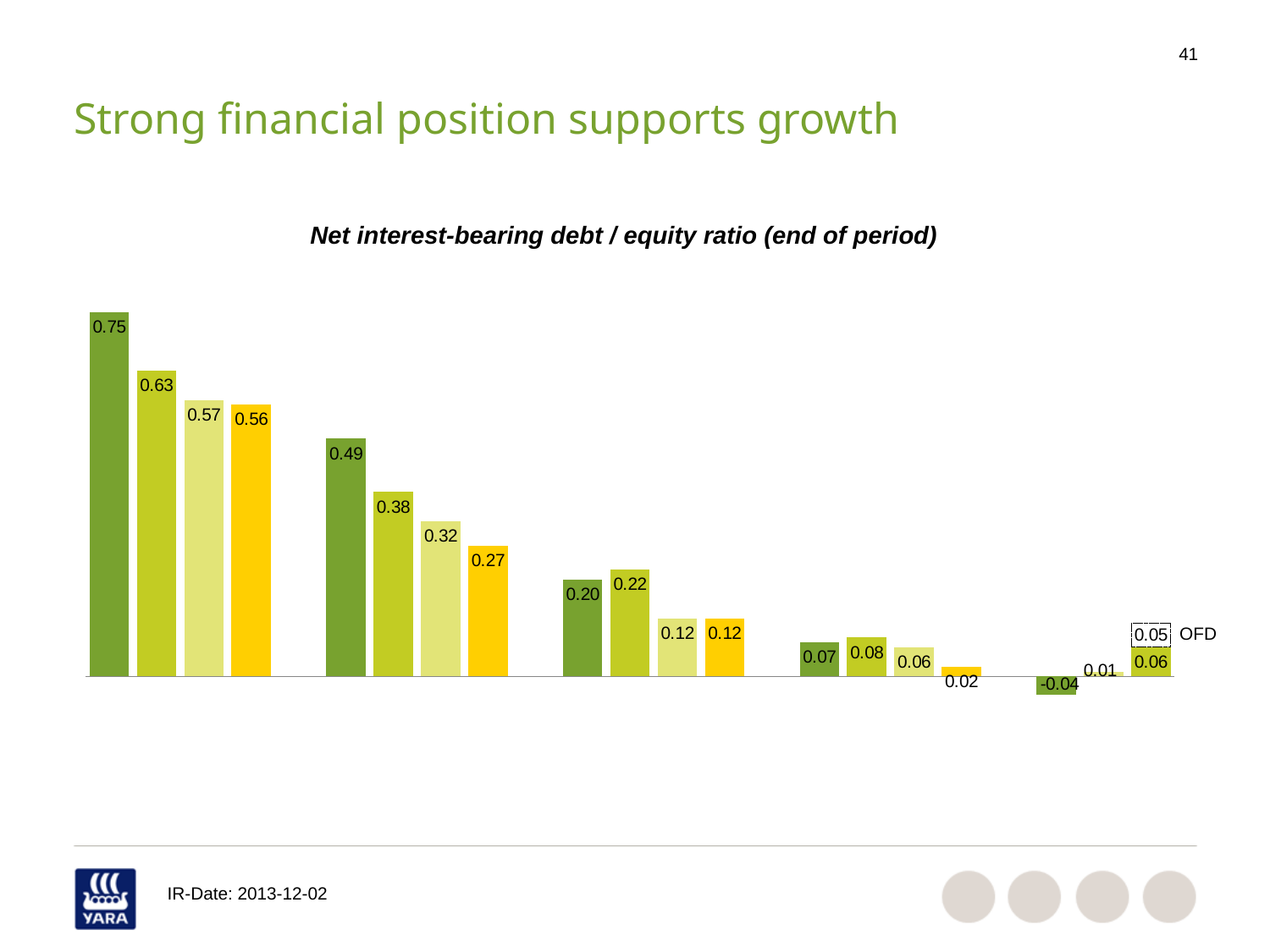
What is the highest value shown in the chart? 0.75 What is the value of the first bar in the second group of bars? 0.49 How many groups of bars are there in the chart? 5 What label appears next to the dashed box showing 0.05 above the last bar? OFD What is the value of the first (leftmost) bar in the chart? 0.75 What kind of chart is shown on the slide? Bar chart What is the difference between the first bar (0.75) and the second bar (0.63)? 0.12 Do the values generally rise or fall from left to right across the chart? Fall How many bars are plotted in the chart? 19 What is the value of the last (rightmost) bar in the chart? 0.06 What is the lowest value shown in the chart? -0.04 What is the title of the chart? Net interest-bearing debt / equity ratio (end of period)